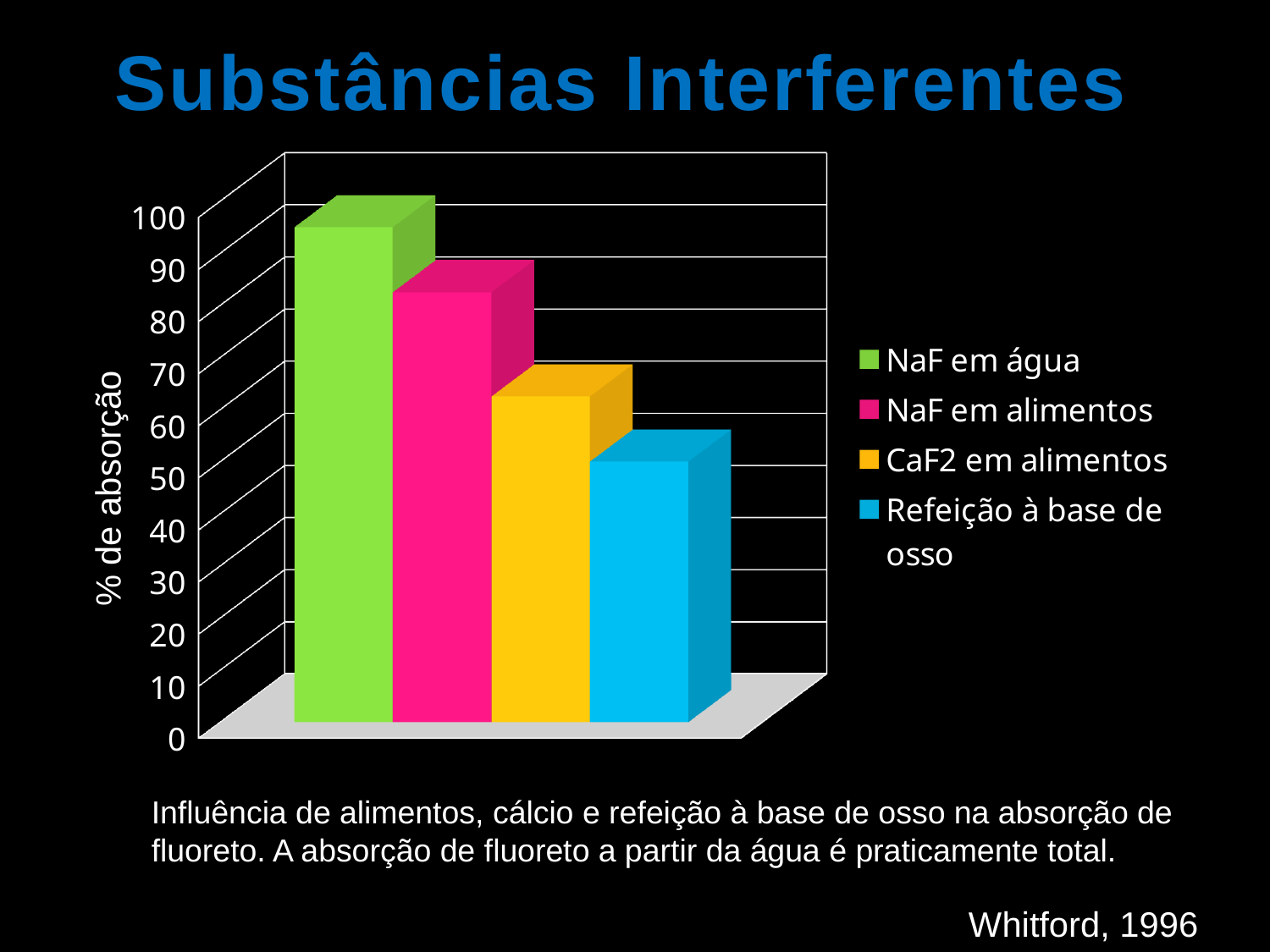
Which is larger, the value for NaF em alimentos or the value for CaF2 em alimentos? NaF em alimentos Is the value for Refeição à base de osso greater or less than 70? less Is the value for NaF em água greater or less than 90? greater What kind of chart is shown on the slide? bar chart Is the value for CaF2 em alimentos greater or less than 80? less Which series has the highest % de absorção? NaF em água What is the label of the vertical axis? % de absorção Do the bar values rise or fall from left to right across the chart? fall How many bars are plotted in the chart? 4 Which series has the lowest % de absorção? Refeição à base de osso How many series does the legend list? 4